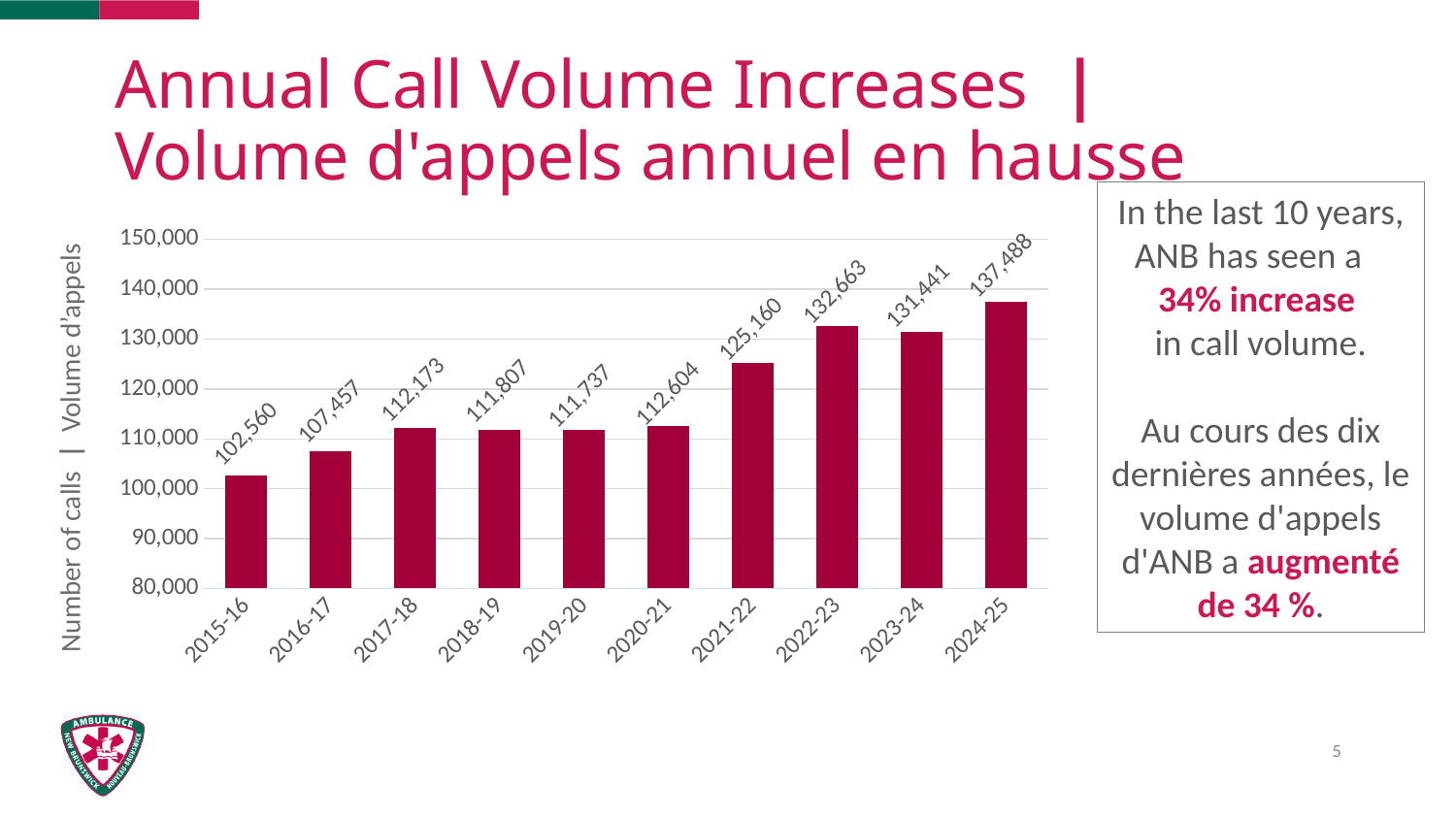
What is the number of calls for 2024-25? 137,488 What is the difference in number of calls between 2024-25 and 2015-16? 34,928 What is the number of calls for 2015-16? 102,560 What is the number of calls for 2021-22? 125,160 Which year has more calls, 2022-23 or 2023-24? 2022-23 Is the value for 2021-22 greater or less than 120,000? greater What is the difference in number of calls between 2021-22 and 2020-21? 12,556 What kind of chart is shown on the slide? bar chart How many years are shown on the chart? 10 Which year has the highest number of calls? 2024-25 Do the call volumes generally rise or fall from 2015-16 to 2024-25? rise Which year has the lowest number of calls? 2015-16